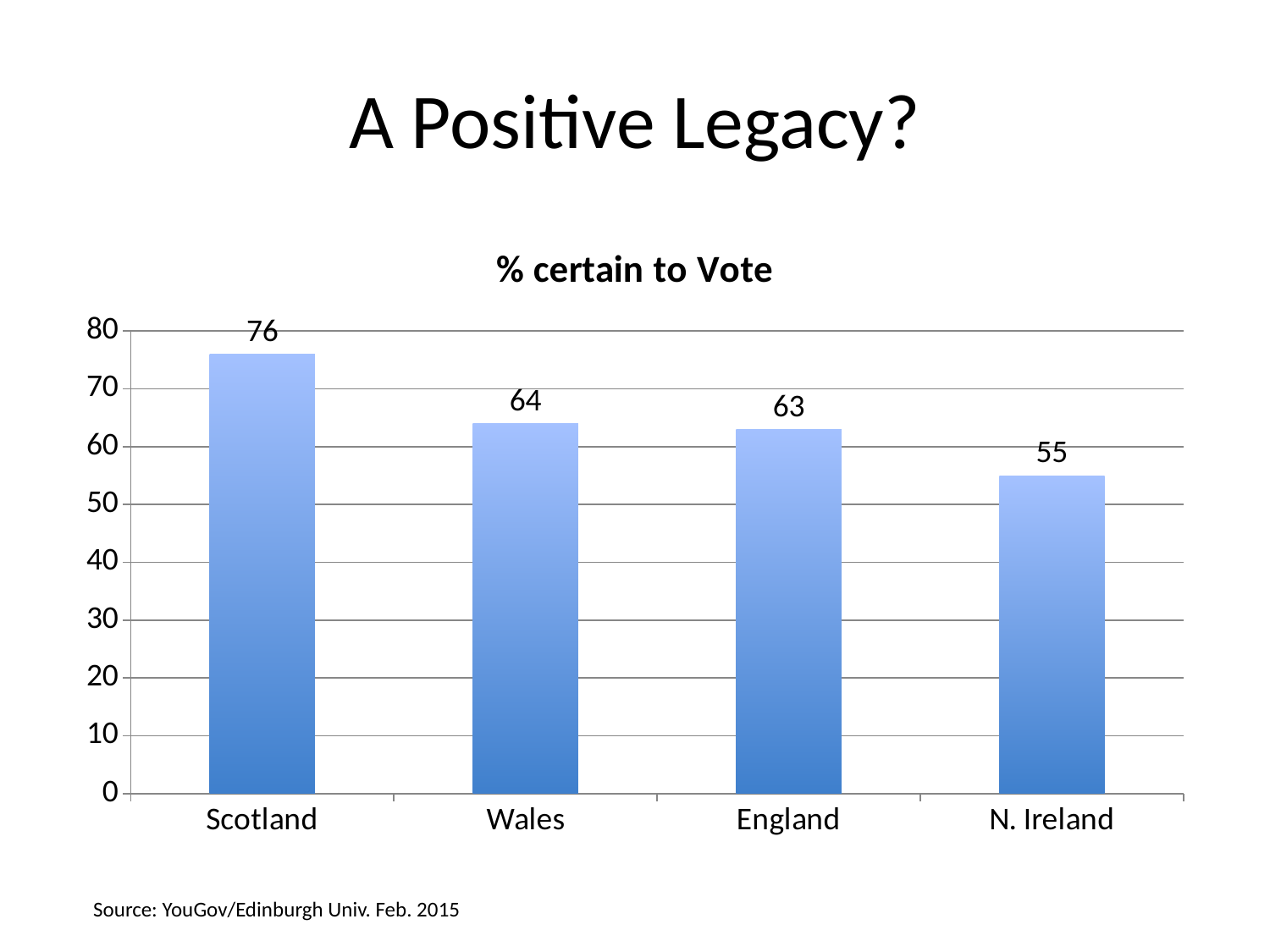
What kind of chart is shown on the slide? bar chart What is the value for N. Ireland? 55 Which category has the highest value? Scotland Which is larger, the value for Scotland or the value for Wales? Scotland How many categories are shown on the chart? 4 What is the value for Wales? 64 What is the difference between the values for Scotland and N. Ireland? 21 Which category has the lowest value? N. Ireland What is the difference between the values for Wales and England? 1 What is the value for England? 63 What is the value for Scotland? 76 What is the title of the chart? % certain to Vote